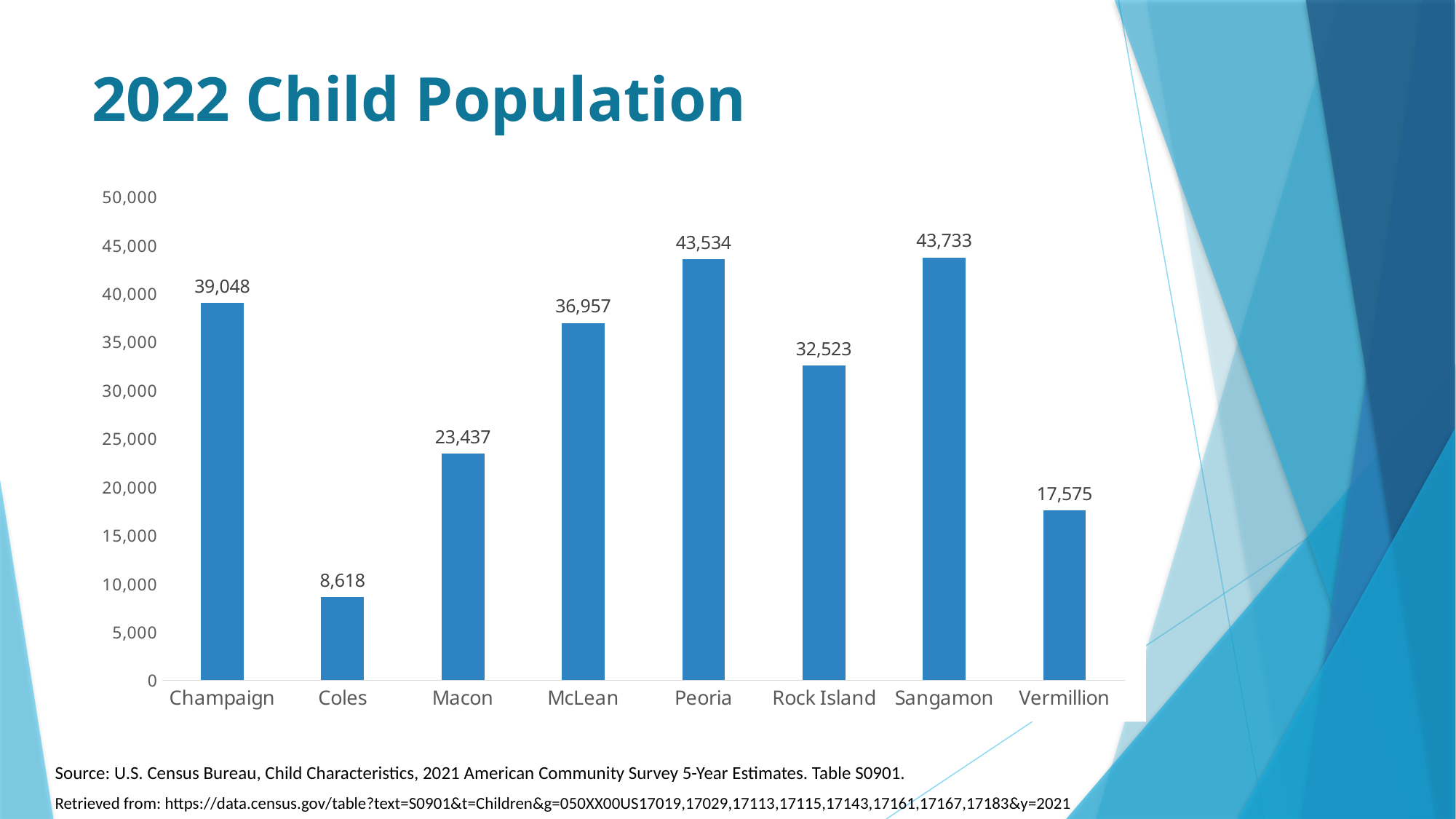
Which county has the highest child population in the chart? Sangamon What is the difference between the values for Champaign and Coles? 30,430 What is the value shown for Rock Island? 32,523 How many counties are shown in the chart? 8 What is the difference between the values for Peoria and Rock Island? 11,011 What is the title of the slide? 2022 Child Population What kind of chart is shown on the slide? Bar chart Is the value for Macon greater or less than 25,000? less What is the 2022 child population shown for Champaign? 39,048 Which county has the lowest child population in the chart? Coles Which has a larger child population, McLean or Macon? McLean What is the value shown for Vermillion? 17,575